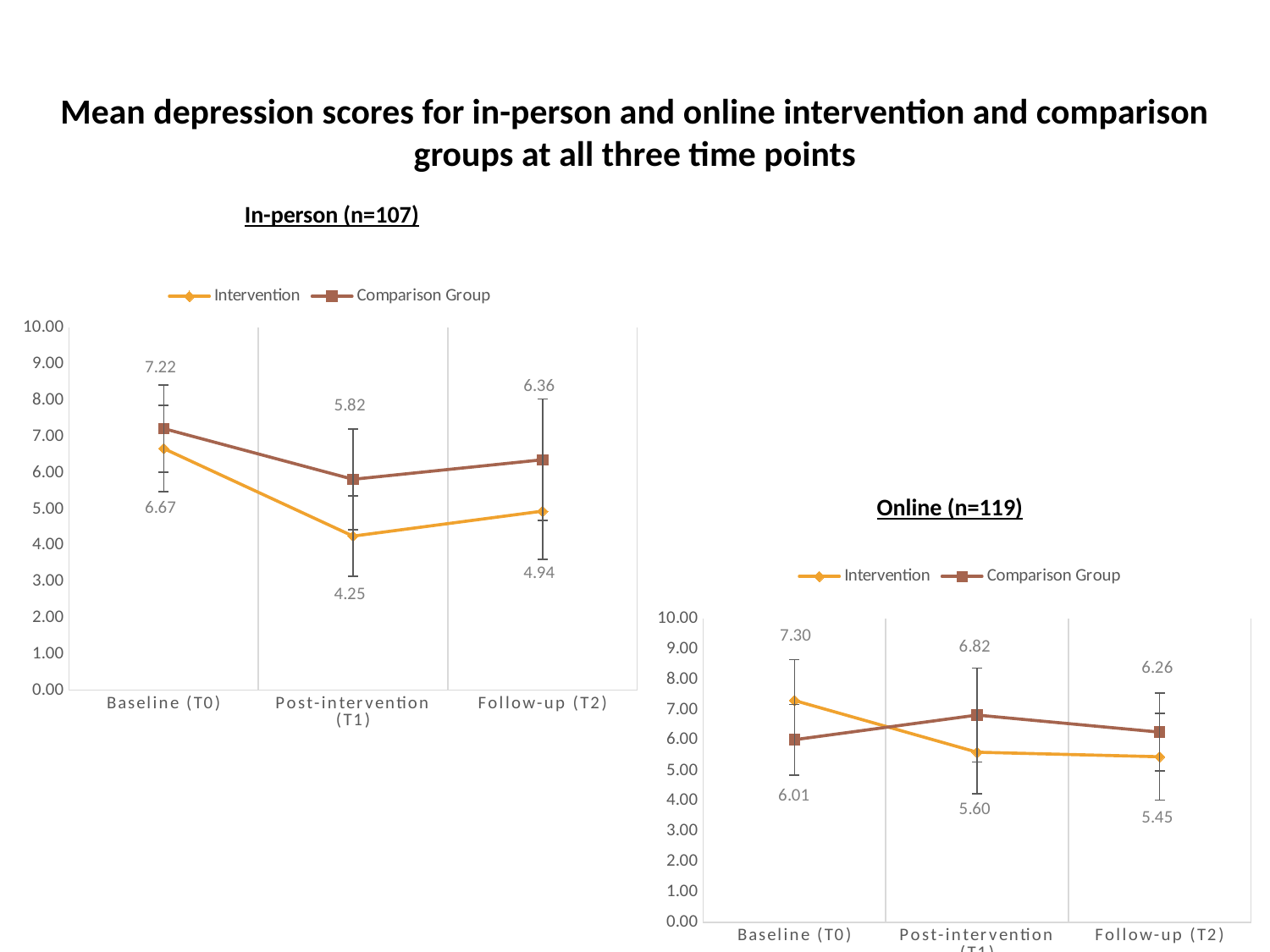
What kind of chart is the Online (n=119) chart? Line chart How many series does the legend of the In-person (n=107) chart list? 2 In the In-person (n=107) chart, at which time point is the Intervention value lowest? Post-intervention (T1) In the Online (n=119) chart, what is the difference between the Intervention and Comparison Group values at Baseline (T0)? 1.29 In the Online (n=119) chart, what is the Comparison Group value at Post-intervention (T1)? 6.82 In the In-person (n=107) chart, what is the Comparison Group value at Baseline (T0)? 7.22 In the Online (n=119) chart, does the Intervention series rise or fall from Baseline (T0) to Follow-up (T2)? Fall In the In-person (n=107) chart, what is the Intervention value at Post-intervention (T1)? 4.25 In the In-person (n=107) chart, what is the difference between the Comparison Group and Intervention values at Follow-up (T2)? 1.42 In the Online (n=119) chart, at which time point is the Comparison Group value highest? Post-intervention (T1) In the Online (n=119) chart, what is the Intervention value at Follow-up (T2)? 5.45 In the Online (n=119) chart, which series has the larger value at Baseline (T0), Intervention or Comparison Group? Intervention